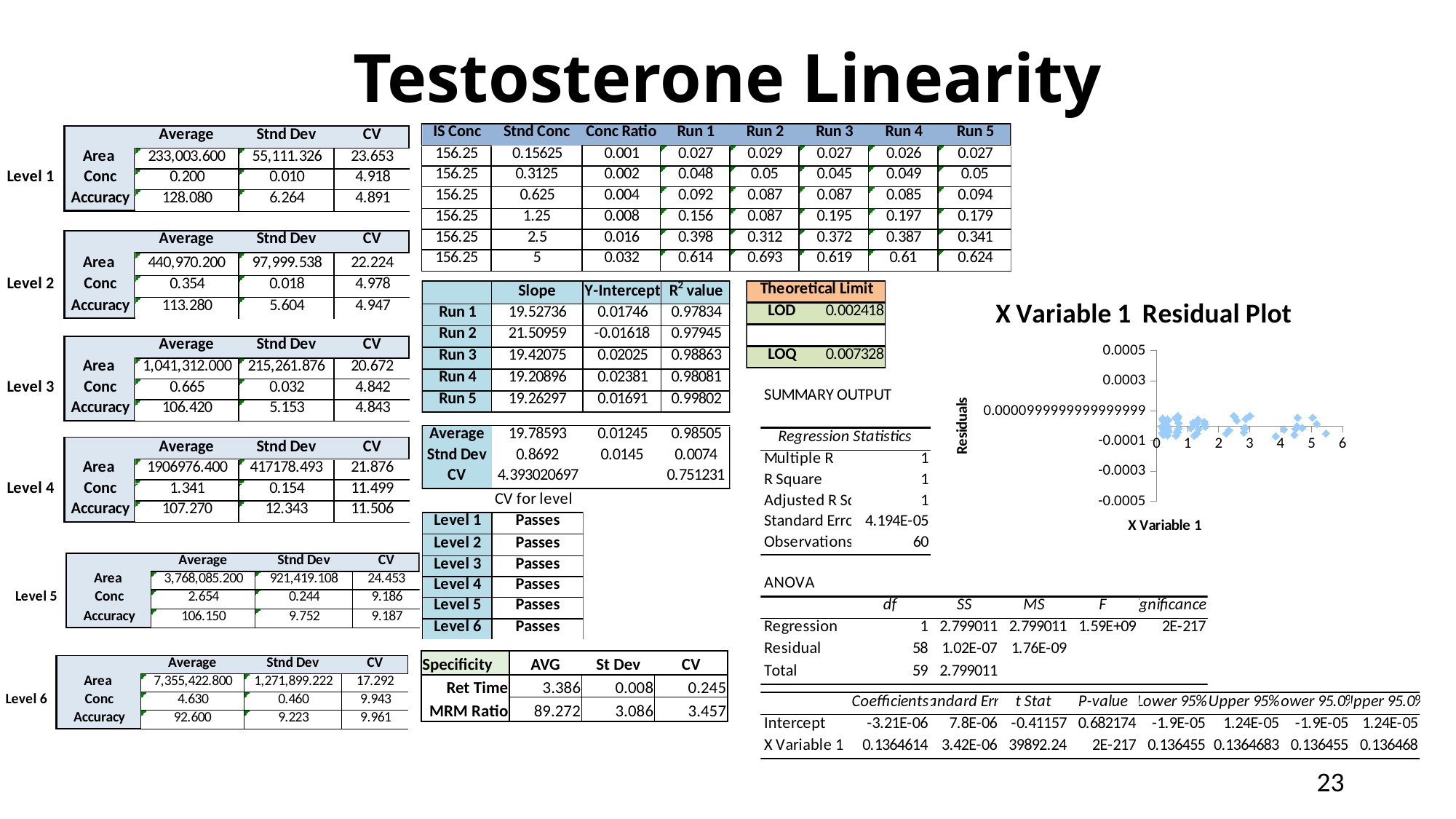
In the residual plot, are the plotted residual values greater or less than 0.0005? less What is the label of the vertical axis of the residual plot? Residuals What kind of chart is the "X Variable 1 Residual Plot"? scatter plot In the residual plot, are the plotted residual values greater or less than 0.0003? less In the residual plot, are the plotted residual values greater or less than -0.0003? greater What is the title of the chart on the slide? X Variable 1 Residual Plot